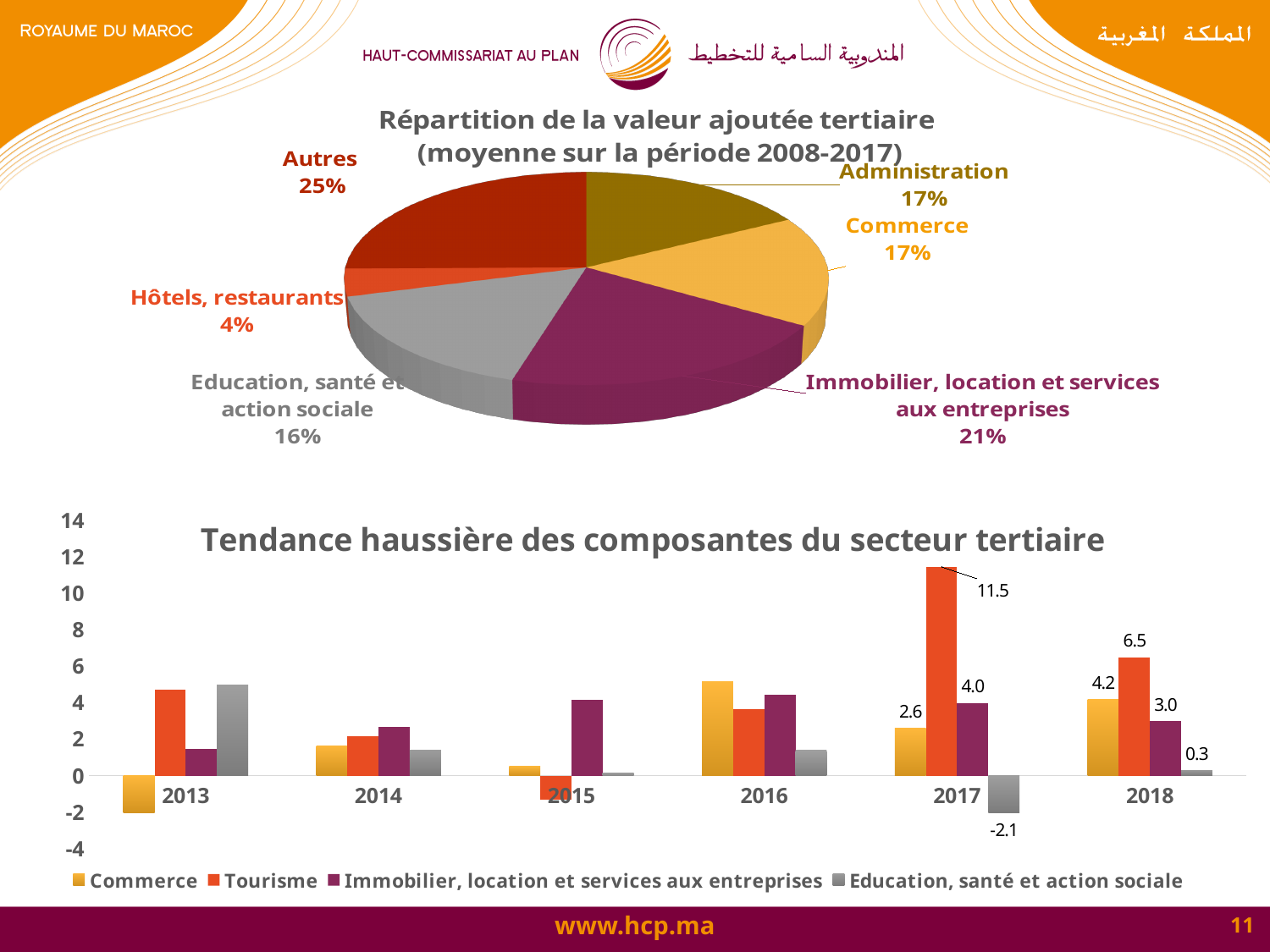
In the chart 'Tendance haussière des composantes du secteur tertiaire', what is the value for Tourisme in 2017? 11.5 How many series does the legend of the chart 'Tendance haussière des composantes du secteur tertiaire' list? 4 How many slices does the pie chart 'Répartition de la valeur ajoutée tertiaire' have? 6 In the pie chart 'Répartition de la valeur ajoutée tertiaire', what is the share of 'Immobilier, location et services aux entreprises'? 21% In the chart 'Tendance haussière des composantes du secteur tertiaire', what is the value for 'Education, santé et action sociale' in 2017? -2.1 In the chart 'Tendance haussière des composantes du secteur tertiaire', what is the difference between the Tourisme values for 2017 and 2018? 5.0 In the chart 'Tendance haussière des composantes du secteur tertiaire', which is larger in 2018: Commerce or 'Immobilier, location et services aux entreprises'? Commerce In the pie chart 'Répartition de la valeur ajoutée tertiaire', what share does 'Autres' represent? 25% In the pie chart 'Répartition de la valeur ajoutée tertiaire', which category has the smallest share? Hôtels, restaurants What kind of chart is 'Tendance haussière des composantes du secteur tertiaire'? Bar chart In the chart 'Tendance haussière des composantes du secteur tertiaire', is the value for Commerce in 2016 greater or less than 4? greater In the pie chart 'Répartition de la valeur ajoutée tertiaire', which category has the largest share? Autres